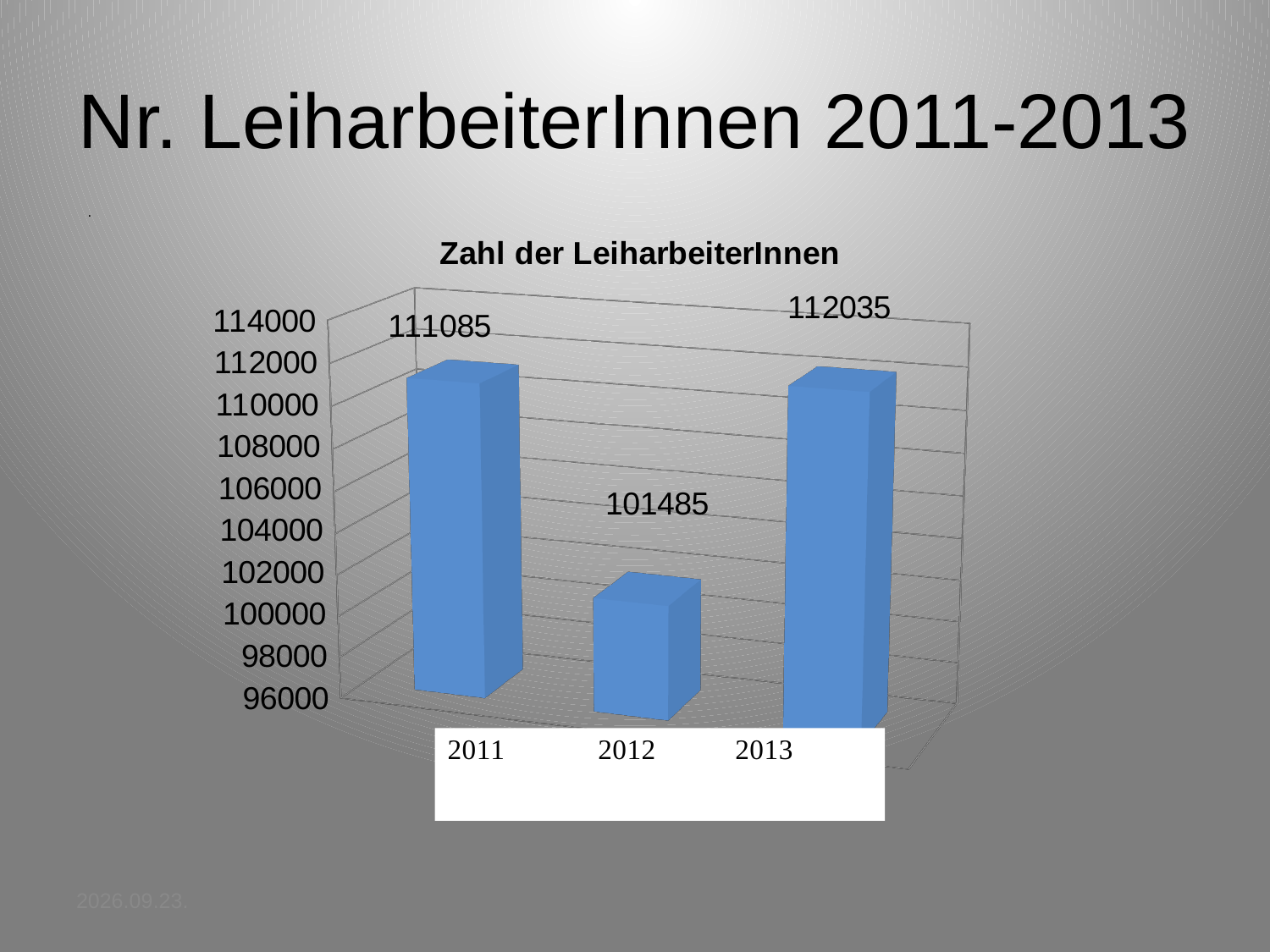
What is the value for 2013? 112035 What kind of chart is shown? bar chart Is the value for 2012 greater or less than 104000? less How many years are shown on the chart? 3 What is the title of the chart? Zahl der LeiharbeiterInnen Which year has the lowest value? 2012 What is the difference between the values for 2013 and 2012? 10550 What is the difference between the values for 2013 and 2011? 950 What is the value for 2011? 111085 What is the value for 2012? 101485 Which year has the highest value? 2013 Which is larger, the value for 2011 or the value for 2012? 2011